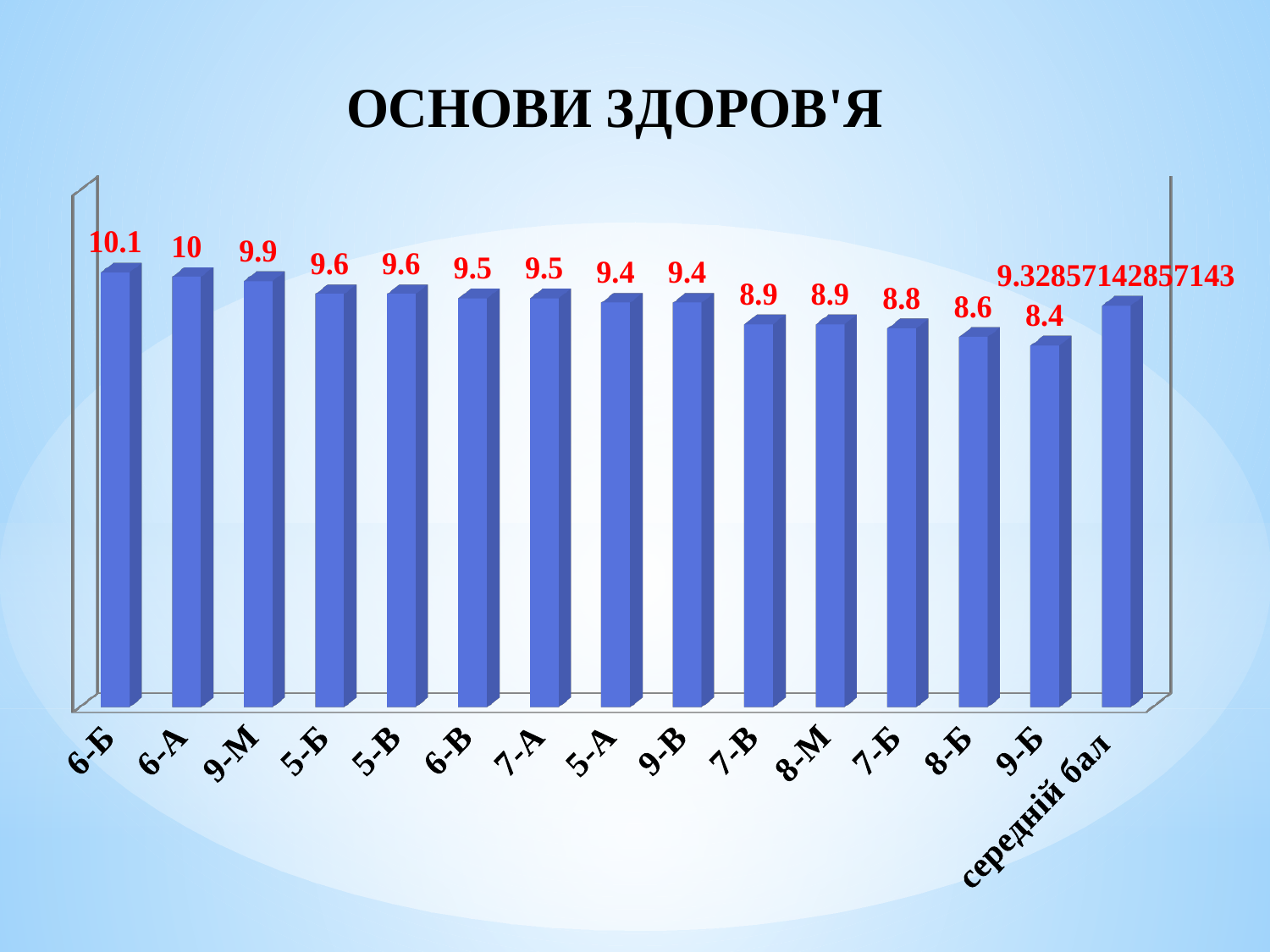
Which is larger, the value for 9-М or the value for 8-Б? 9-М What is the value for 9-Б? 8.4 What is the title of the chart? ОСНОВИ ЗДОРОВ'Я What kind of chart is shown on the slide? Bar chart What is the difference between the values for 6-Б and 9-Б? 1.7 What is the value shown for середній бал? 9.32857142857143 How many bars are plotted on the chart? 15 Which category has the lowest value? 9-Б Which category has the highest value? 6-Б What is the value for 6-Б? 10.1 Do the values for the class categories rise or fall from 6-Б to 9-Б along the x axis? Fall What is the value for 7-Б? 8.8